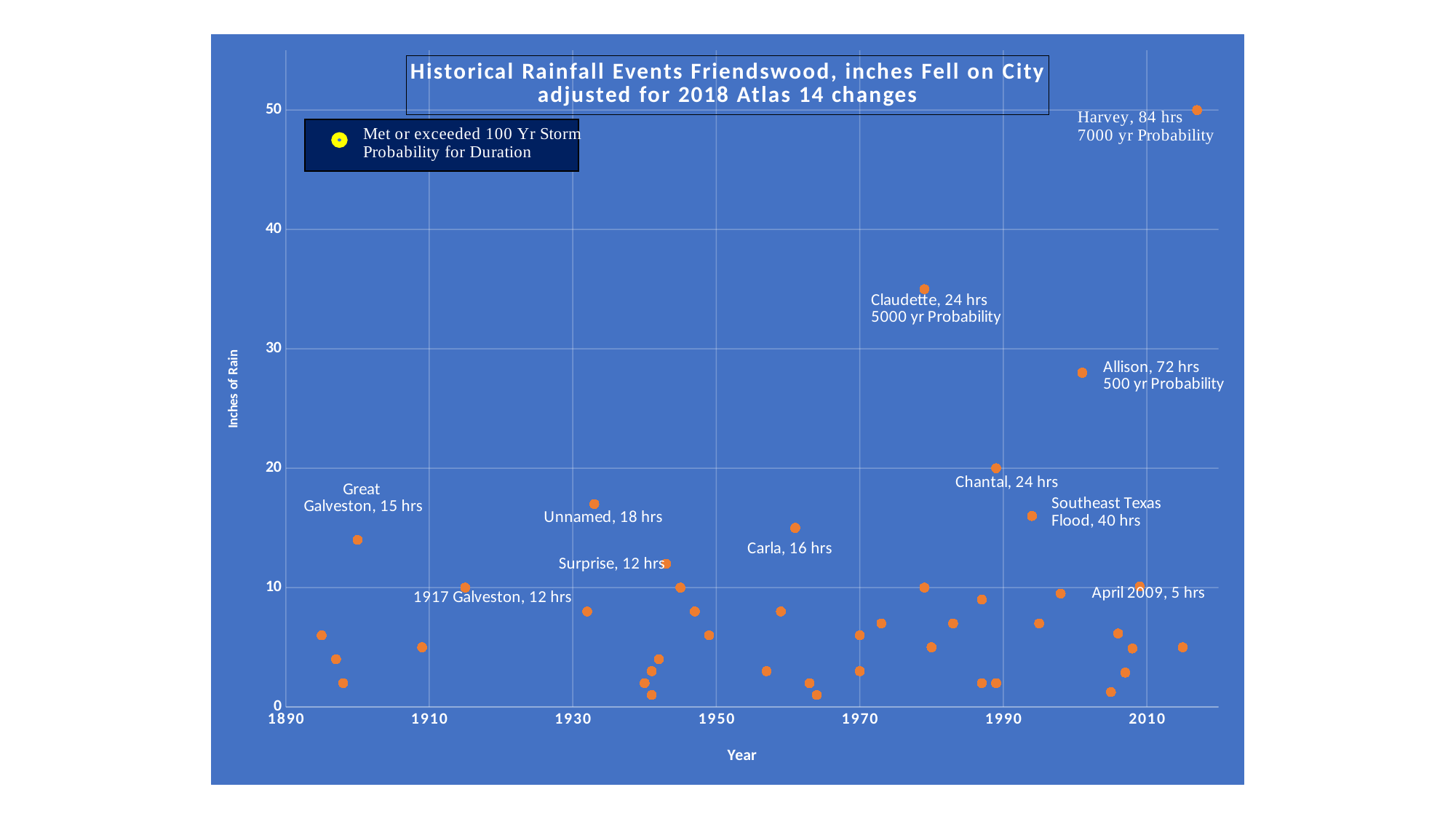
Is the value for Surprise, 12 hrs greater or less than 10? greater Is the value for Allison, 72 hrs greater or less than 30? less What is the label of the y axis? Inches of Rain What is the title of the chart? Historical Rainfall Events Friendswood, inches Fell on City adjusted for 2018 Atlas 14 changes How many inches of rain are plotted for Harvey, 84 hrs? 50 What probability is given for Claudette, 24 hrs? 5000 yr Probability How many inches of rain are plotted for Chantal, 24 hrs? 20 Which labelled event has the highest inches of rain? Harvey, 84 hrs Which event has more inches of rain, Claudette, 24 hrs or Allison, 72 hrs? Claudette, 24 hrs Is the value for Claudette, 24 hrs greater or less than 30? greater What kind of chart is shown on the slide? scatter chart Which event has more inches of rain, Carla, 16 hrs or Great Galveston, 15 hrs? Carla, 16 hrs